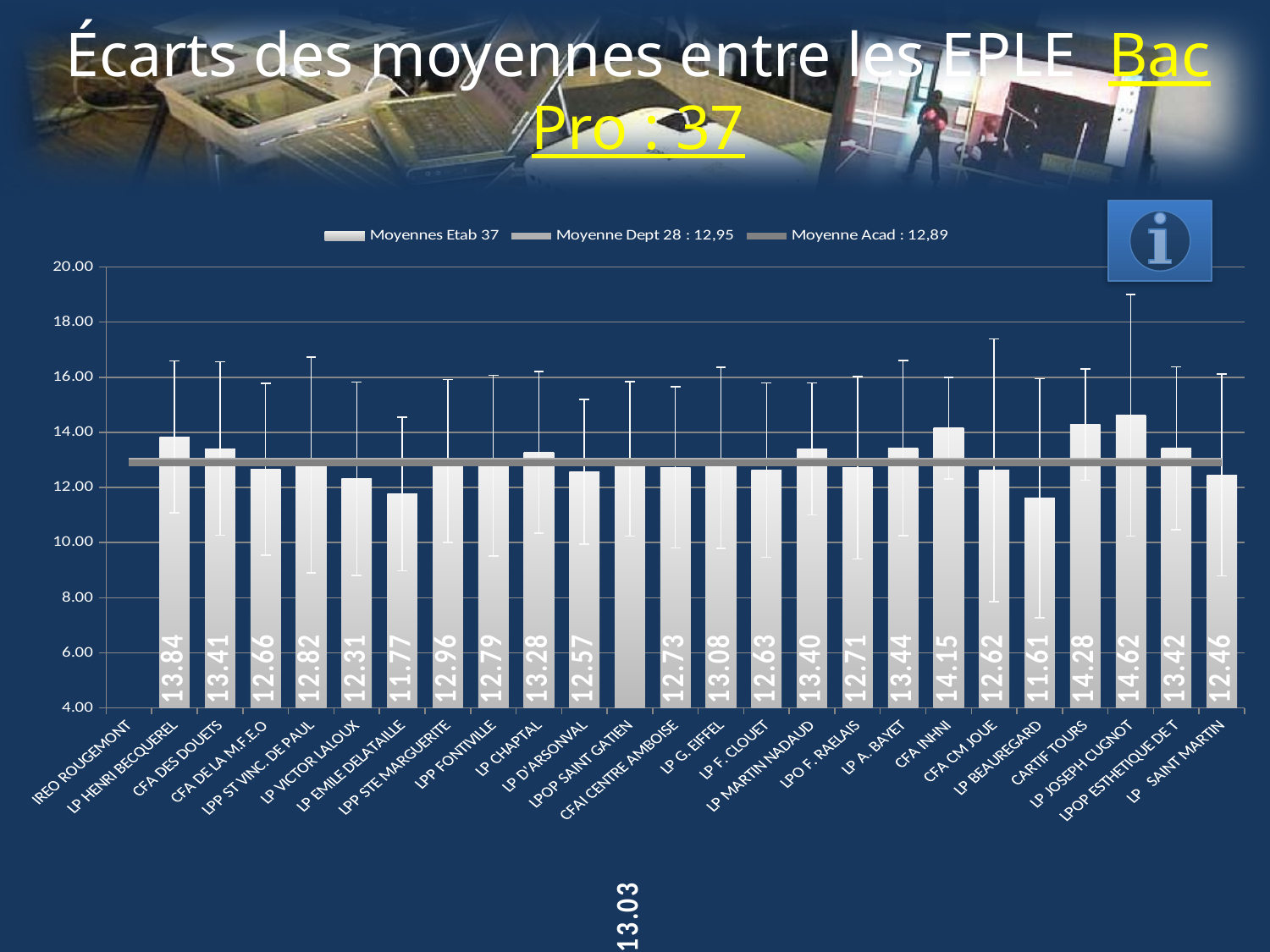
What kind of chart is shown on the slide? bar chart Is the value for LP JOSEPH CUGNOT greater or less than 14.00? greater What is the lowest value shown on any bar in the chart? 11.61 What is the value shown for CFA INHNI? 14.15 What is the highest value shown on any bar in the chart? 14.62 What is the difference between the highest bar value (14.62) and the lowest bar value (11.61)? 3.01 How many series does the chart legend list? 3 What is the value shown for LP HENRI BECQUEREL? 13.84 Which establishment has the highest bar in the chart? LP JOSEPH CUGNOT According to the legend, what is the value of 'Moyenne Dept 28'? 12,95 Which is larger, the value for CARTIF TOURS or the value for LP SAINT MARTIN? CARTIF TOURS Which establishment has the lowest bar in the chart? LP BEAUREGARD